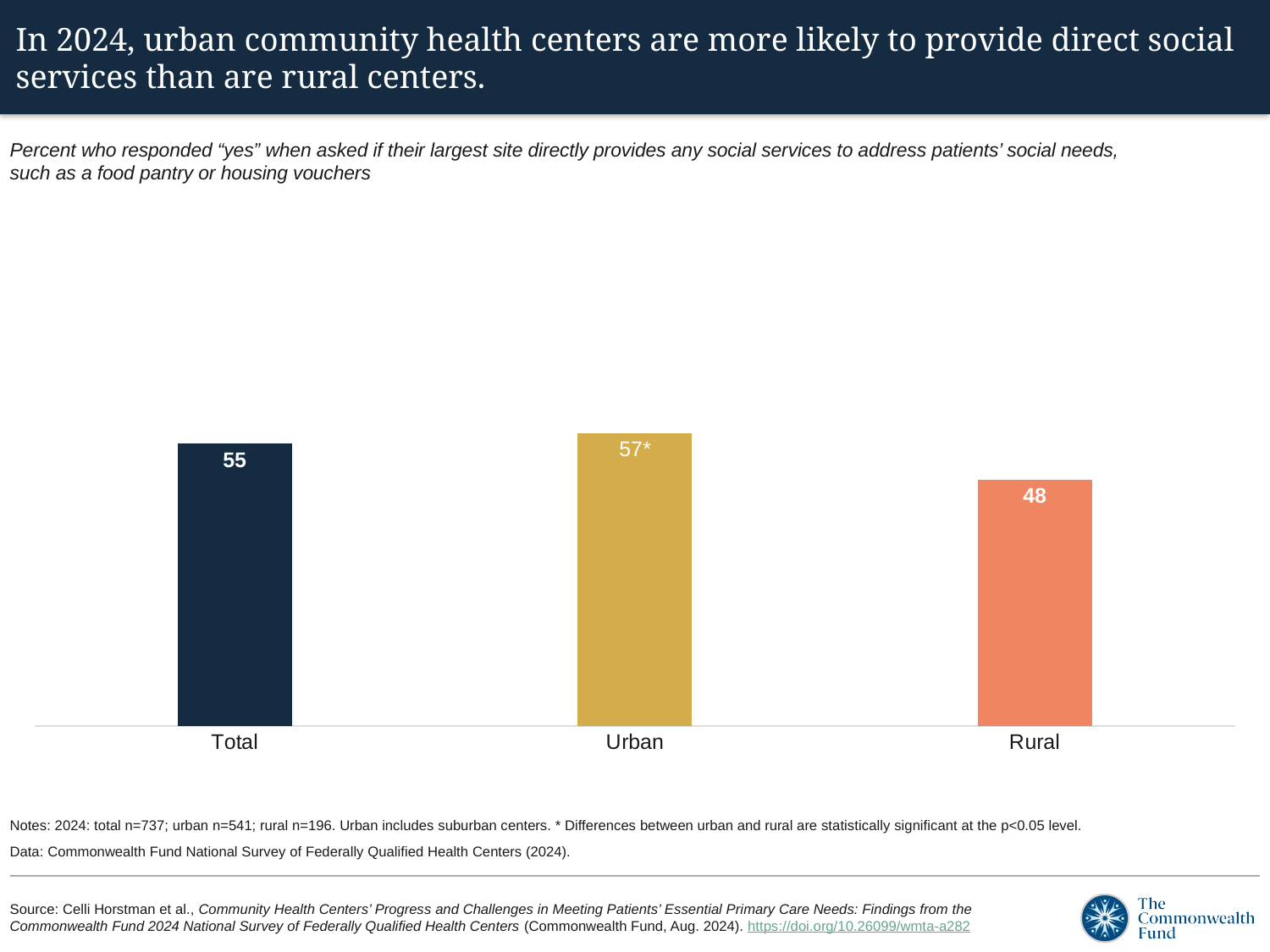
What kind of chart is shown on the slide? Bar chart Which category's data label is marked with an asterisk? Urban How many categories are shown on the chart? 3 What is the difference between the Total and Rural values? 7 Which is larger, the value for Urban or the value for Rural? Urban Which category has the lowest value? Rural What is the value for Total? 55 What is the difference between the Urban and Rural values? 9 Which category has the highest value? Urban What is the value for Urban? 57* What colour is the Rural bar? Orange What is the value for Rural? 48